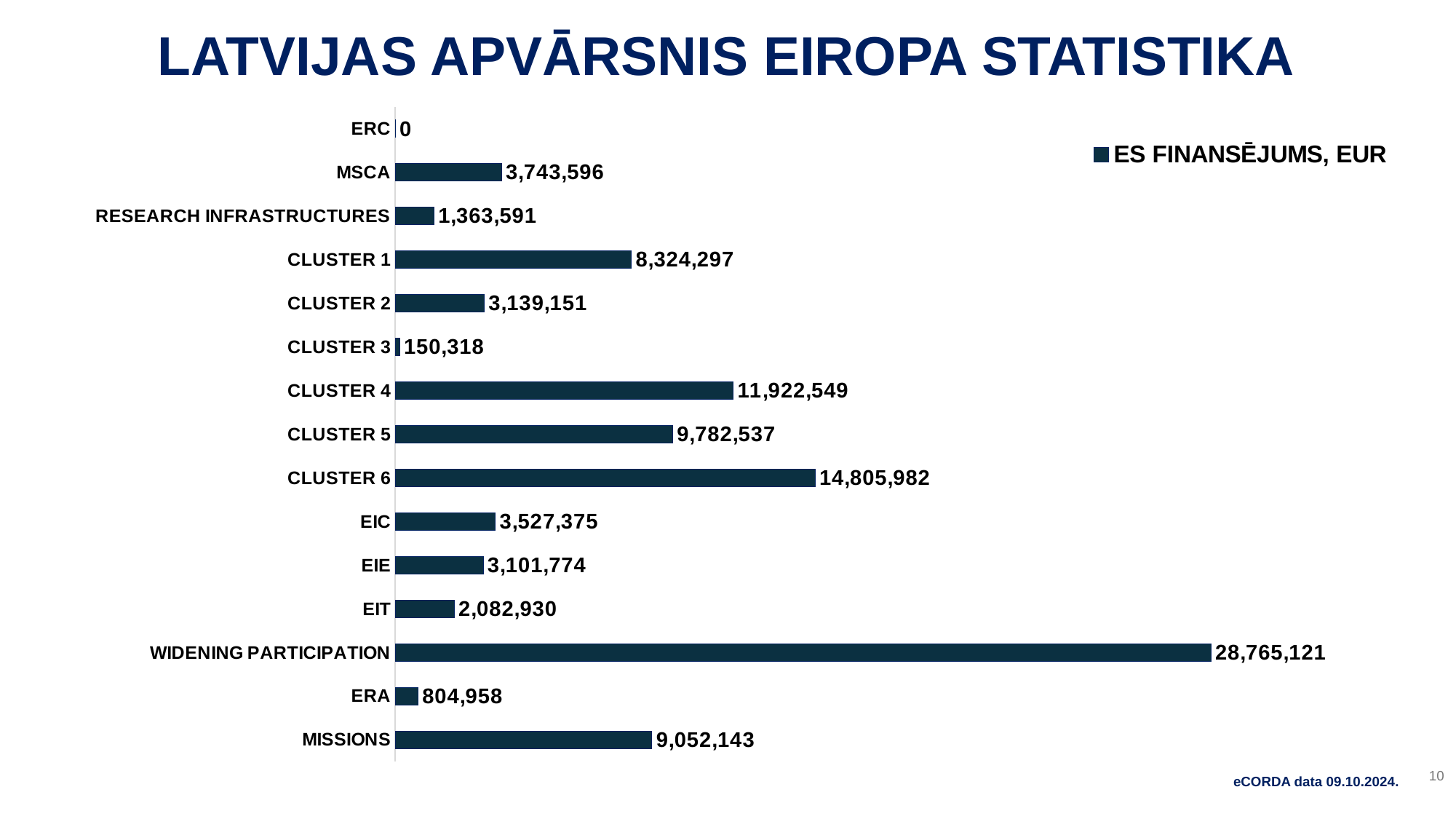
What is the difference between the values for CLUSTER 6 and CLUSTER 4? 2,883,433 Which has a larger value, CLUSTER 5 or MISSIONS? CLUSTER 5 What series name does the legend show? ES FINANSĒJUMS, EUR How many categories are shown on the chart? 15 What is the ES FINANSĒJUMS, EUR value for CLUSTER 4? 11,922,549 What is the value shown for WIDENING PARTICIPATION? 28,765,121 Which category has the highest value? WIDENING PARTICIPATION What is the value shown for RESEARCH INFRASTRUCTURES? 1,363,591 What is the value shown for MISSIONS? 9,052,143 Which category has the lowest value? ERC What kind of chart is shown on the slide? Bar chart What is the difference between the values for WIDENING PARTICIPATION and CLUSTER 6? 13,959,139